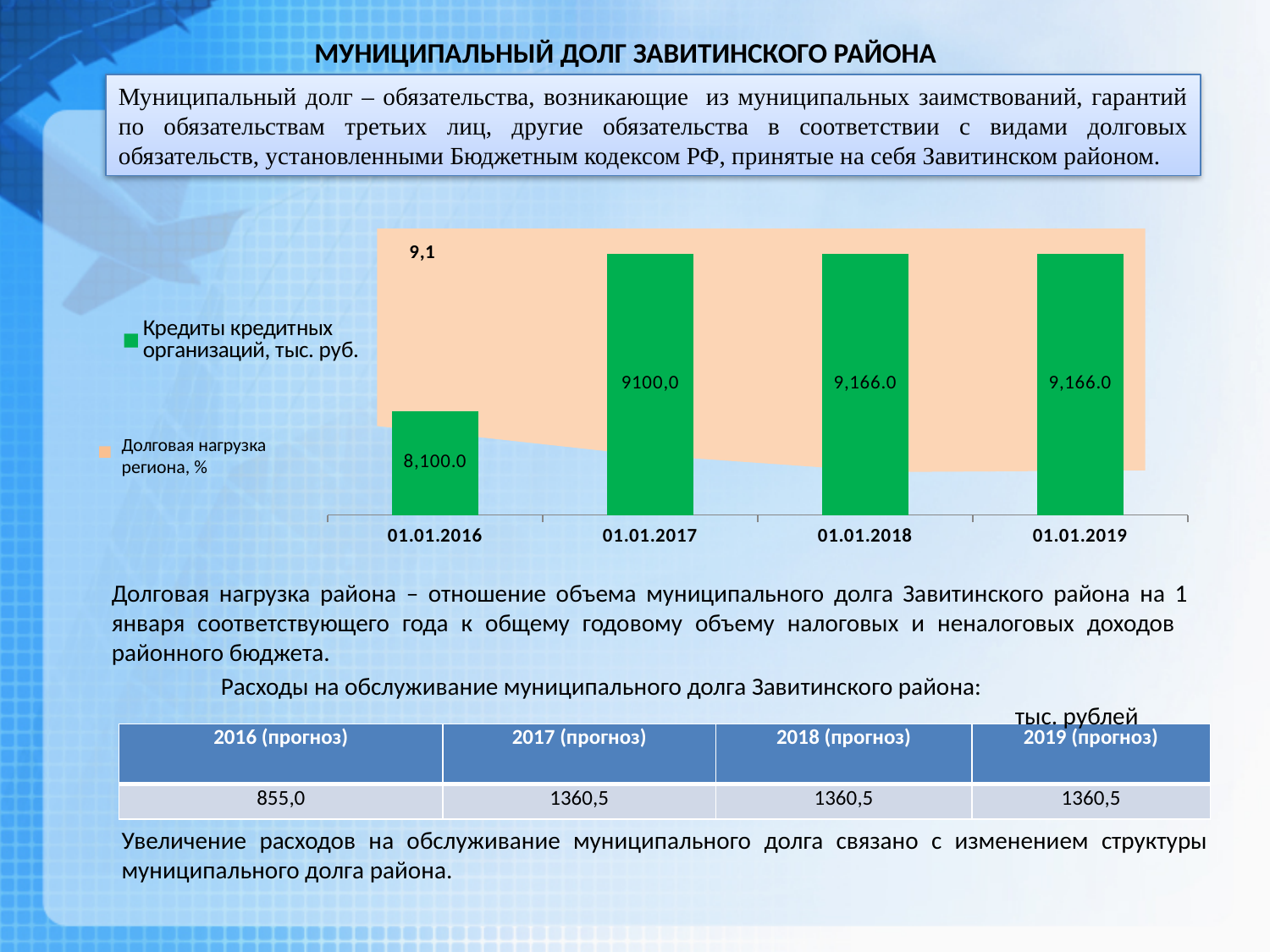
How many series does the chart legend list? 2 What is the value of Кредиты кредитных организаций, тыс. руб. for 01.01.2016? 8,100.0 What is the difference between the Кредиты кредитных организаций values for 01.01.2017 and 01.01.2016? 1000.0 Which date has the lowest value for Кредиты кредитных организаций, тыс. руб.? 01.01.2016 What colour are the bars for Кредиты кредитных организаций, тыс. руб.? green What is the value of Кредиты кредитных организаций, тыс. руб. for 01.01.2017? 9100,0 What is the value of Кредиты кредитных организаций, тыс. руб. for 01.01.2019? 9,166.0 Do the values for Кредиты кредитных организаций rise or fall from 01.01.2016 to 01.01.2019? rise How many dates are shown on the x axis of the chart? 4 Which is larger for Кредиты кредитных организаций, тыс. руб.: 01.01.2016 or 01.01.2017? 01.01.2017 What is the difference between the Кредиты кредитных организаций values for 01.01.2018 and 01.01.2017? 66.0